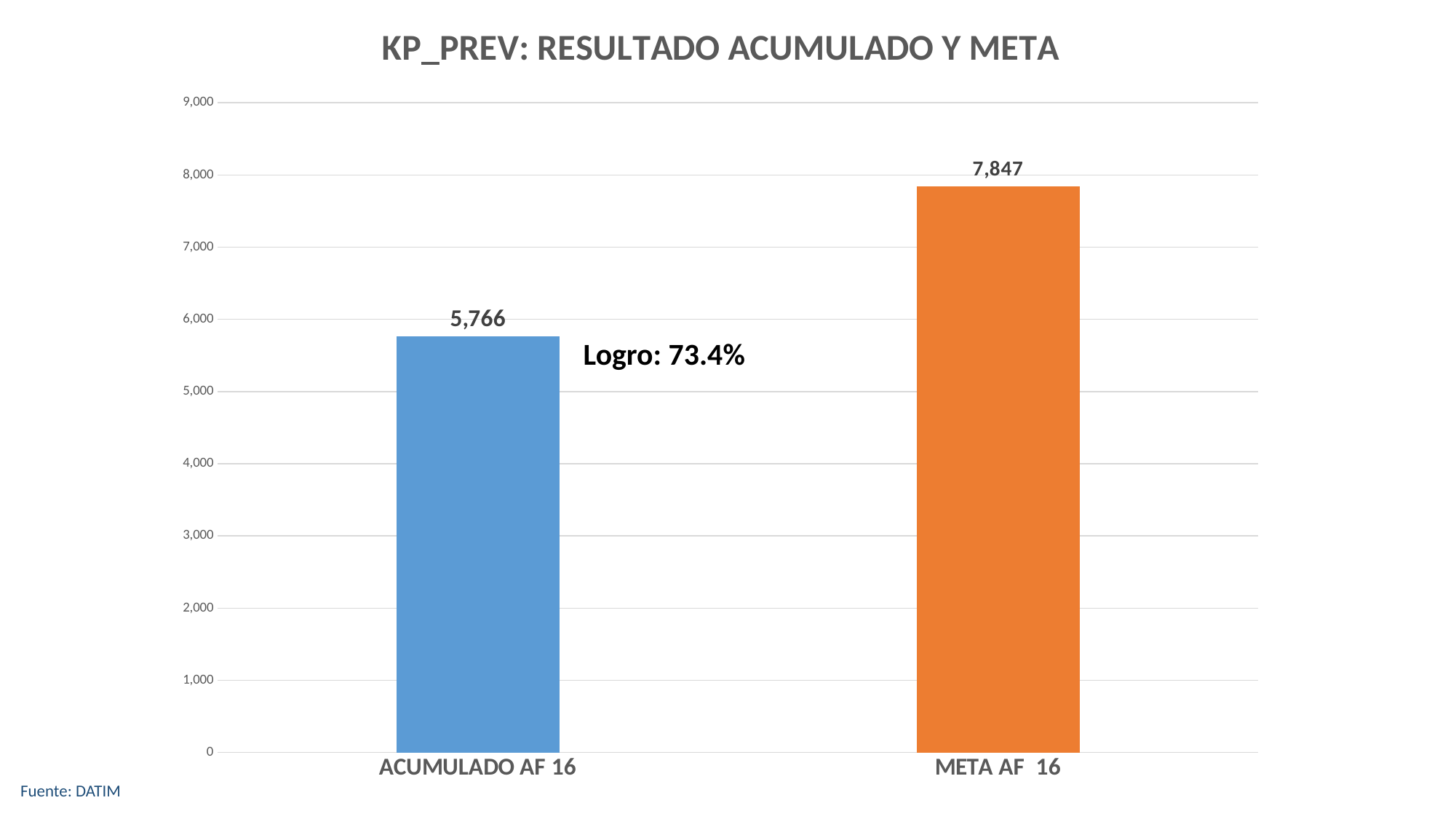
Is the value for META AF 16 greater or less than 7,000? greater How many categories are shown in the chart? 2 What achievement percentage (Logro) is annotated on the chart? 73.4% What is the value for ACUMULADO AF 16? 5,766 What is the difference between META AF 16 and ACUMULADO AF 16? 2,081 Which is larger, ACUMULADO AF 16 or META AF 16? META AF 16 Which category has the highest value? META AF 16 What is the value for META AF 16? 7,847 Is the value for ACUMULADO AF 16 greater or less than 6,000? less Which category has the lowest value? ACUMULADO AF 16 What is the title of the chart? KP_PREV: RESULTADO ACUMULADO Y META What kind of chart is shown on the slide? bar chart